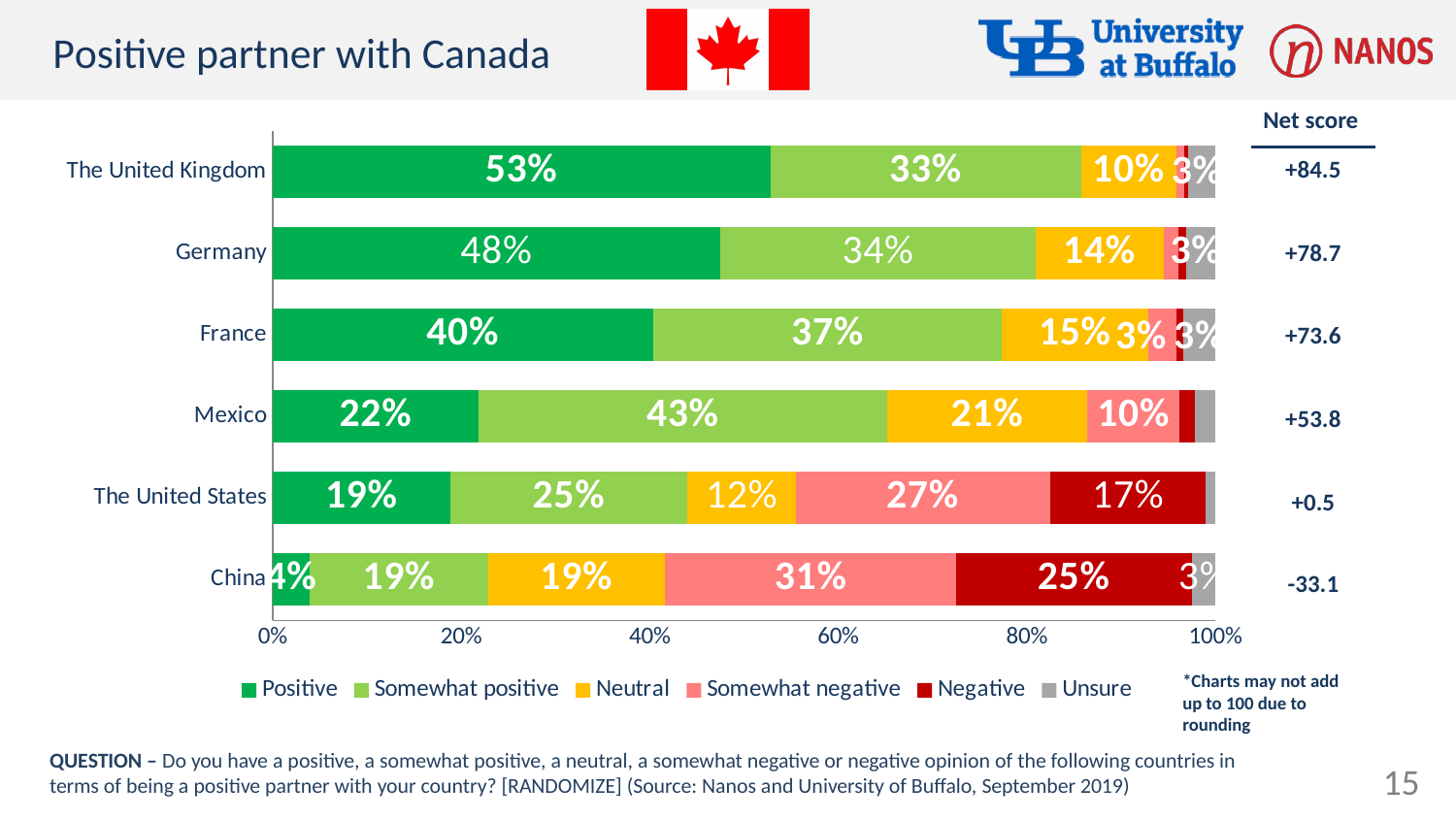
What is the difference between the 'Positive' values for the United Kingdom and Germany? 5 percentage points Which country has the lowest 'Positive' percentage? China What is the 'Somewhat negative' value for China? 31% What is the 'Somewhat positive' value for Mexico? 43% What percentage of respondents have a positive opinion of the United Kingdom as a partner with Canada? 53% How many series does the legend list? 6 How many countries are shown in the chart? 6 Which country has the highest 'Positive' percentage? The United Kingdom What is the net score shown for Germany? +78.7 What is the 'Negative' value for the United States? 17% What type of chart is shown on the slide? Stacked bar chart Which is larger: the 'Neutral' value for France or the 'Neutral' value for Mexico? Mexico